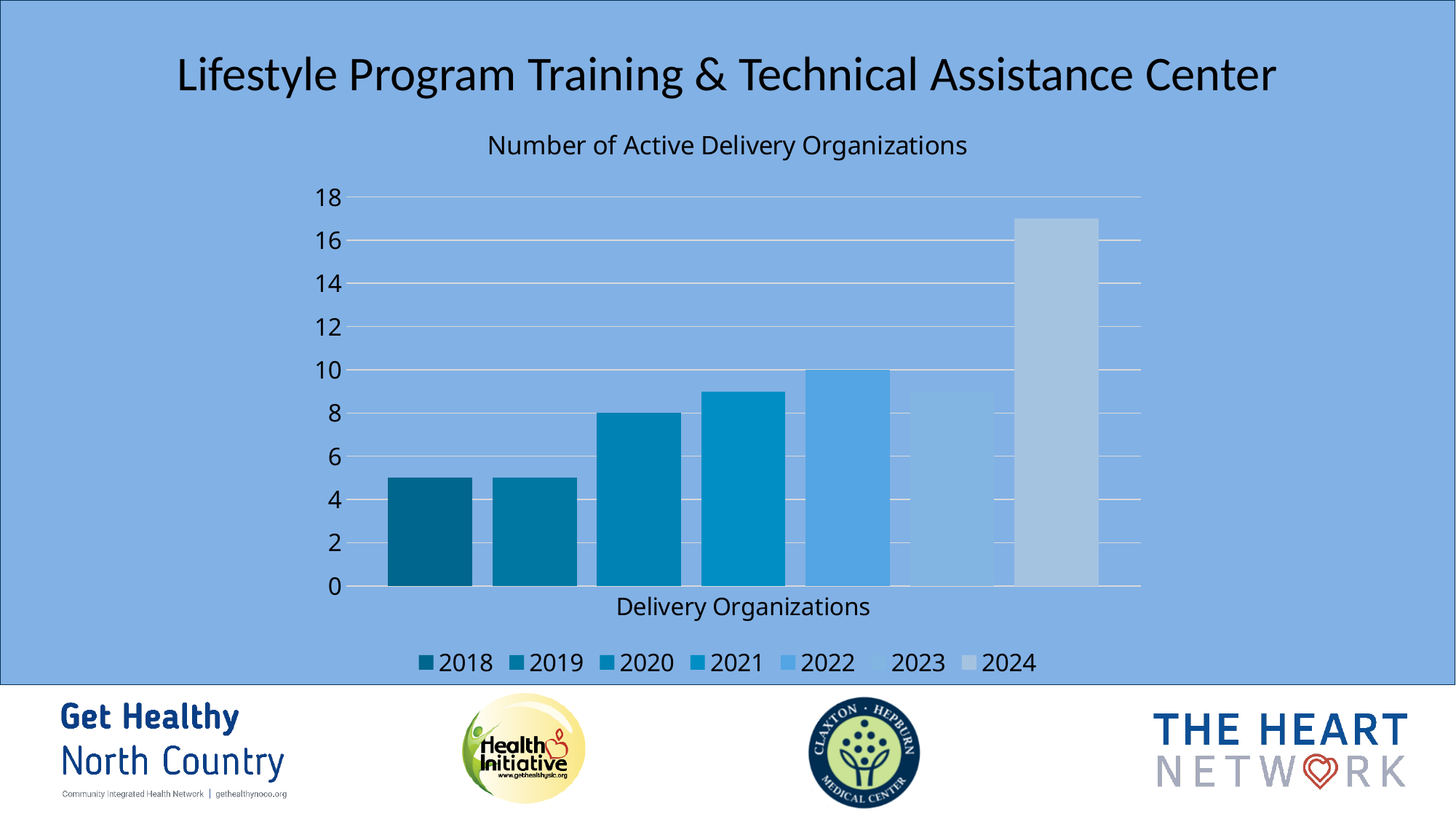
What is the number of active delivery organizations for 2020? 8 Is the value for 2021 greater or less than 8? greater What type of chart is shown on the slide? bar chart What is the difference between the values for 2022 and 2020? 2 Which is larger, the value for 2024 or the value for 2022? 2024 Which year has the highest number of active delivery organizations? 2024 What is the label on the x axis of the chart? Delivery Organizations What is the number of active delivery organizations for 2022? 10 Is the value for 2024 greater or less than 16? greater How many series does the legend list? 7 What is the title of the chart? Number of Active Delivery Organizations Is the value for 2018 greater or less than 6? less